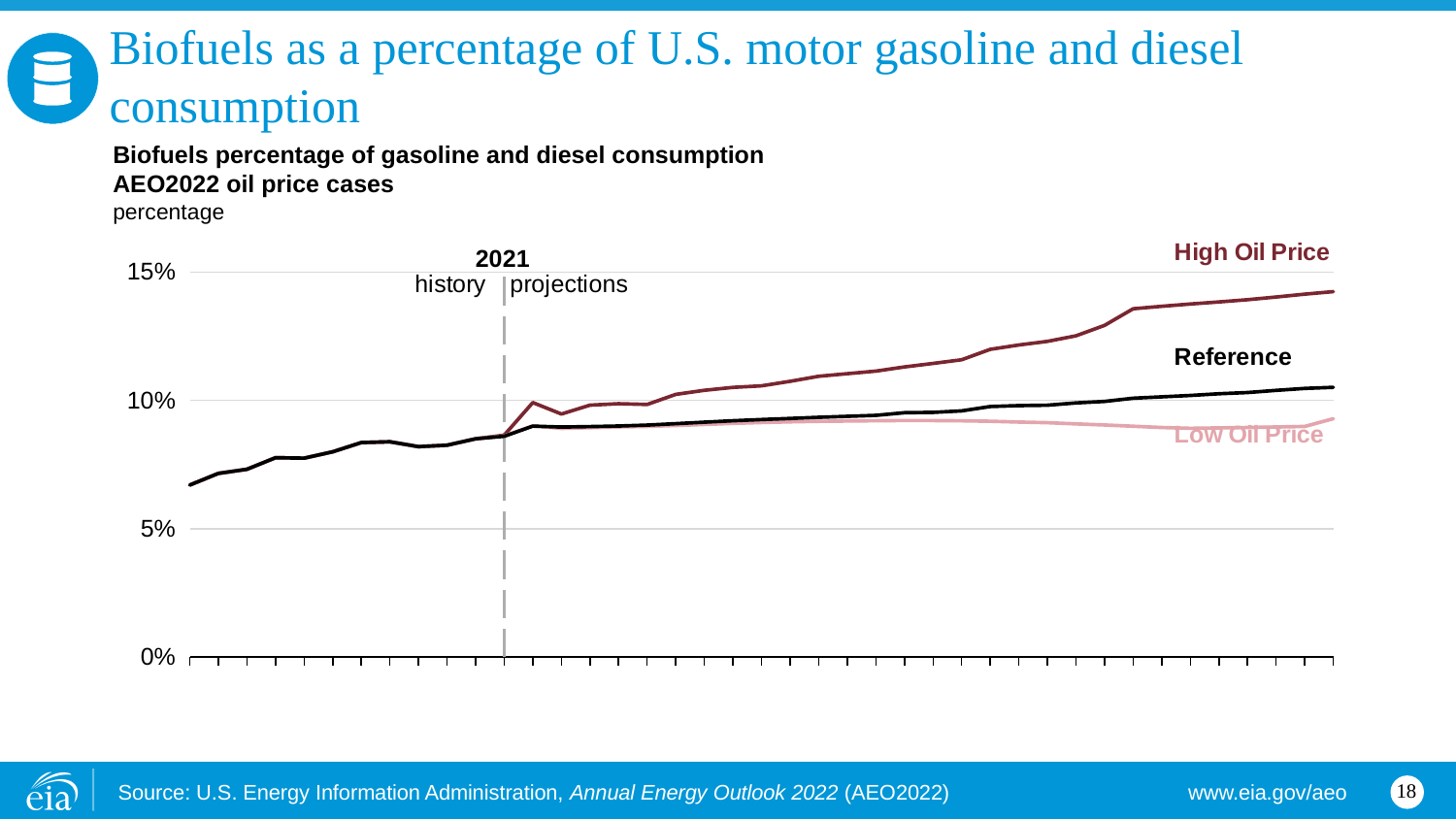
What kind of chart is shown on the slide? line chart Which series has the highest value at the end of the projection period? High Oil Price Is the value at the start of the history period greater or less than 5%? greater Is the High Oil Price value at the end of the projection period greater or less than 10%? greater Does the High Oil Price series rise or fall over the projection period? rise In what year does the chart switch from history to projections? 2021 Which series has the lowest value at the end of the projection period? Low Oil Price What unit is the y axis measured in, according to the label above the chart? percentage Is the Reference case value at the end of the projection period greater or less than 15%? less How many series (oil price cases) are plotted on the chart? 3 At the end of the projection period, which is larger: the Reference case or the Low Oil Price case? Reference